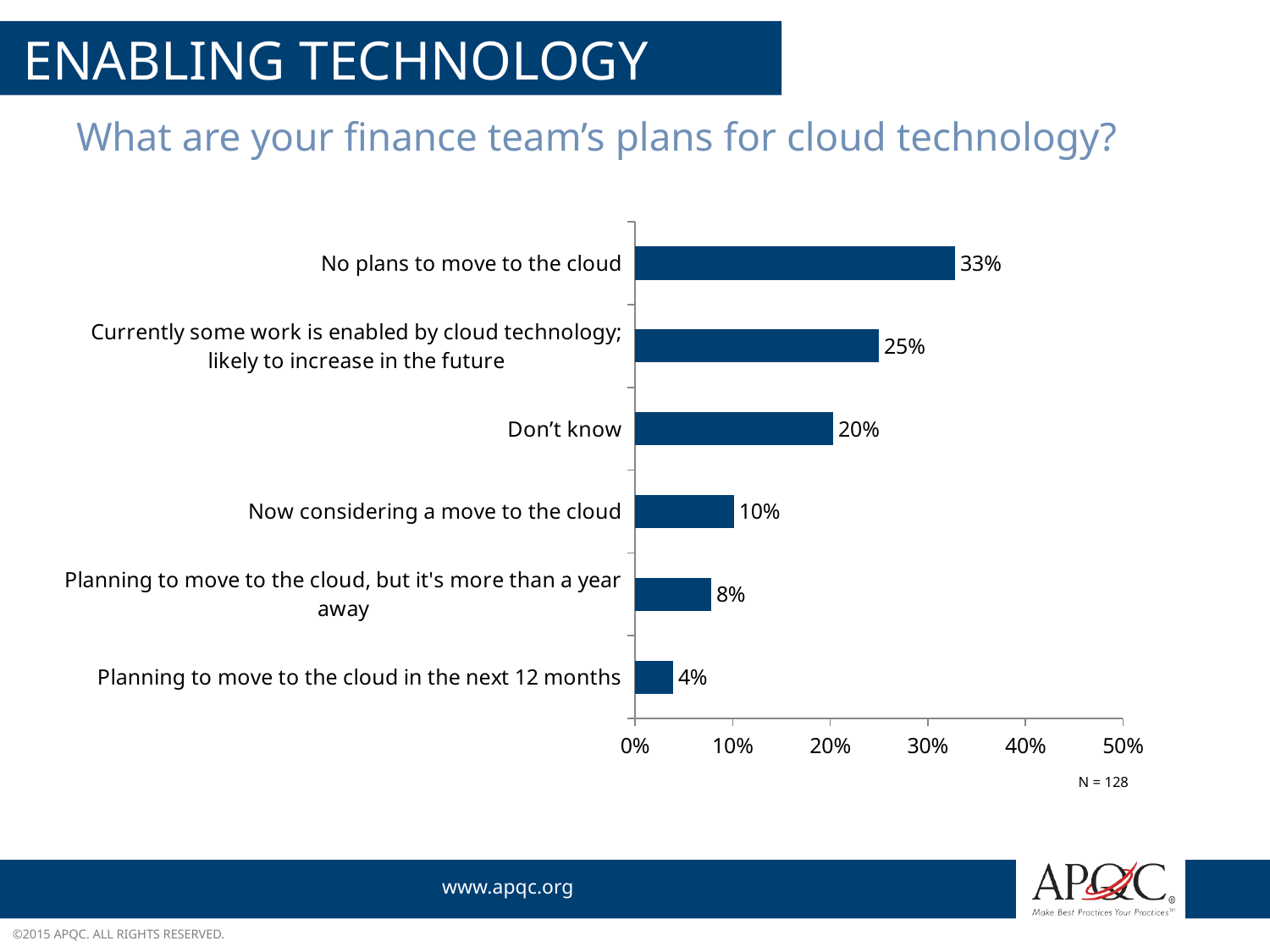
How many response categories are shown in the chart? 6 What is the difference in percentage points between 'No plans to move to the cloud' and 'Currently some work is enabled by cloud technology; likely to increase in the future'? 8 percentage points Which is larger: the percentage for 'Now considering a move to the cloud' or for 'Planning to move to the cloud, but it's more than a year away'? Now considering a move to the cloud What percentage of respondents answered 'Don't know'? 20% What percentage of respondents have no plans to move to the cloud? 33% What kind of chart is shown on the slide? Bar chart What percentage of respondents are planning to move to the cloud in the next 12 months? 4% What percentage of respondents are now considering a move to the cloud? 10% Is the value for 'Currently some work is enabled by cloud technology; likely to increase in the future' greater or less than 30%? less Which response has the highest percentage? No plans to move to the cloud Which response has the lowest percentage? Planning to move to the cloud in the next 12 months What is the sample size (N) noted below the chart? N = 128